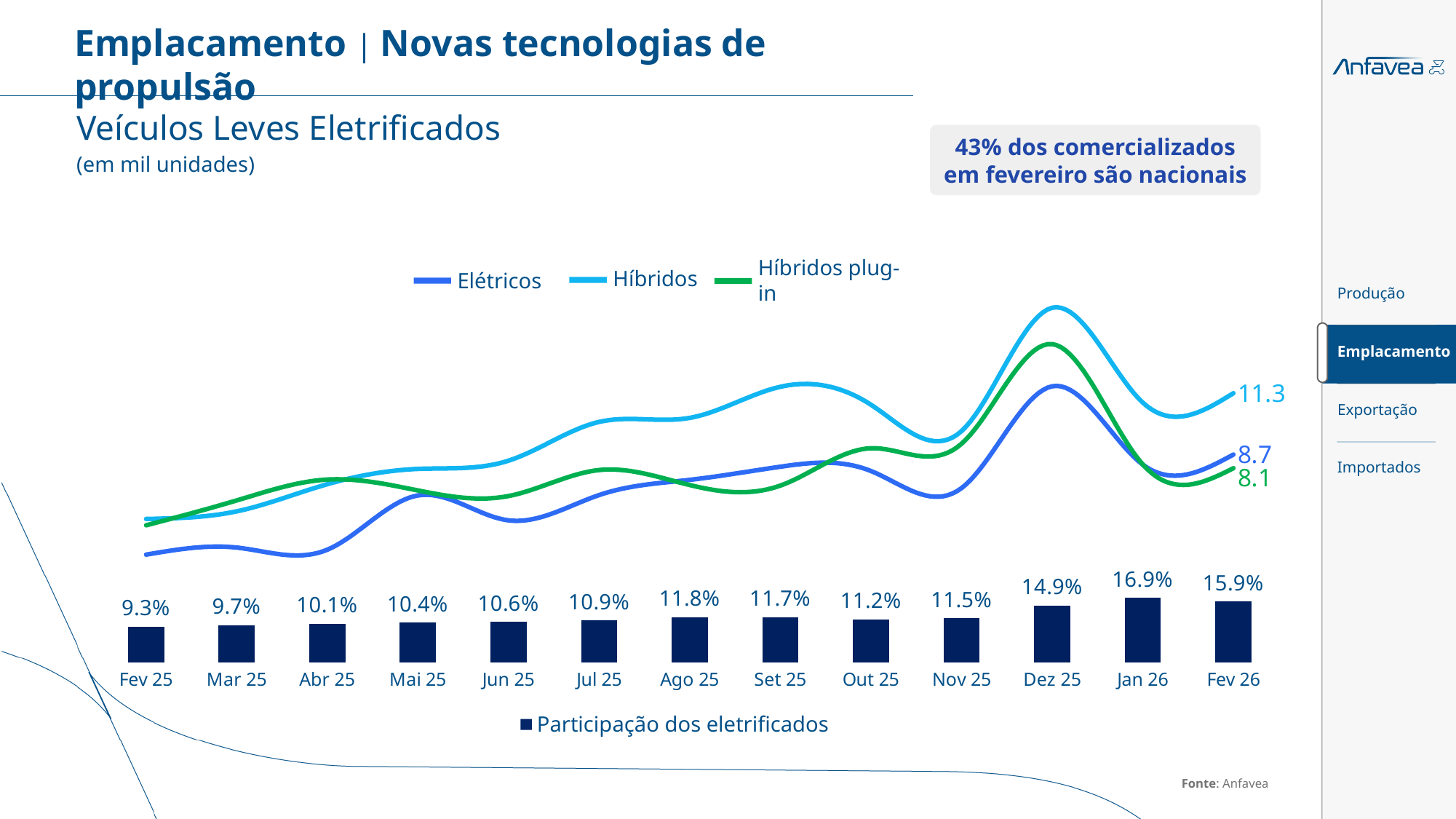
In the line chart of Veículos Leves Eletrificados, what is the difference between the Híbridos and Elétricos values in Fev 26? 2.6 In the bar chart Participação dos eletrificados, how many months are shown? 13 In the line chart of Veículos Leves Eletrificados, what is the value for Elétricos in Fev 26? 8.7 In the line chart of Veículos Leves Eletrificados, how many series does the legend list? 3 What kind of chart is Participação dos eletrificados? Bar chart In the bar chart Participação dos eletrificados, which month has the lowest value? Fev 25 In the bar chart Participação dos eletrificados, what is the difference between Jan 26 and Fev 26? 1.0% In the bar chart Participação dos eletrificados, what is the value for Dez 25? 14.9% In the line chart of Veículos Leves Eletrificados, what is the value for Híbridos plug-in in Fev 26? 8.1 In the bar chart Participação dos eletrificados, which month has the highest value? Jan 26 In the line chart of Veículos Leves Eletrificados, what is the value for Híbridos in Fev 26? 11.3 In the line chart of Veículos Leves Eletrificados, which series has the highest value in Fev 26? Híbridos